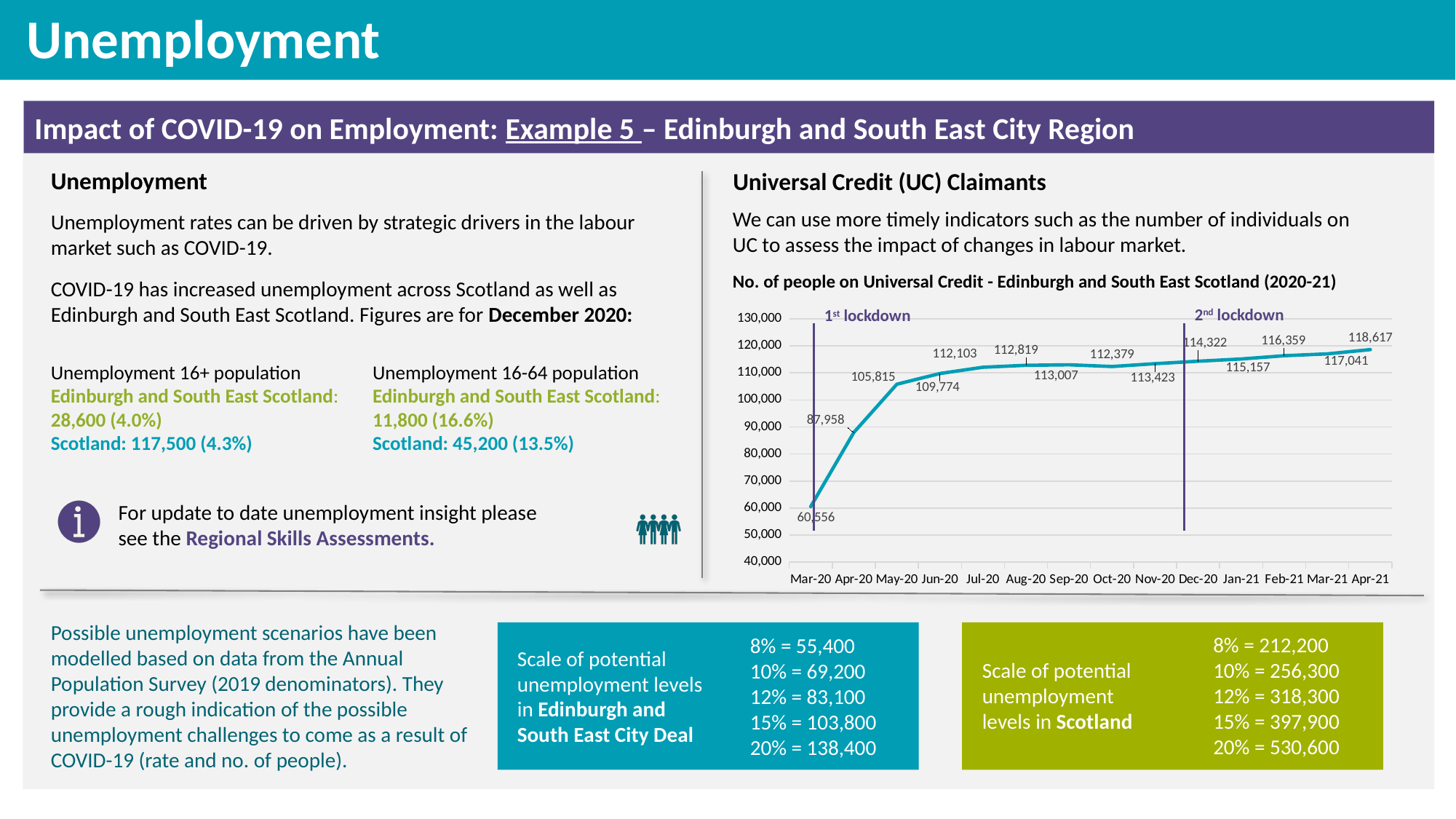
What is the number of people on Universal Credit in Apr-21? 118,617 What is the difference in the number of people on Universal Credit between Apr-20 and Mar-20? 27,402 What type of chart is used to show the number of people on Universal Credit in Edinburgh and South East Scotland? Line chart How many months are plotted on the Universal Credit chart? 14 Which month has the lowest number of people on Universal Credit? Mar-20 Which month has the highest number of people on Universal Credit? Apr-21 What two events are marked by vertical lines on the Universal Credit chart? 1st lockdown and 2nd lockdown What is the number of people on Universal Credit in Mar-20? 60,556 What is the number of people on Universal Credit in Dec-20? 114,322 Does the number of people on Universal Credit generally rise or fall from Mar-20 to Apr-21? Rise Which month has more people on Universal Credit, Sep-20 or Oct-20? Sep-20 Is the number of people on Universal Credit in May-20 greater or less than 100,000? greater